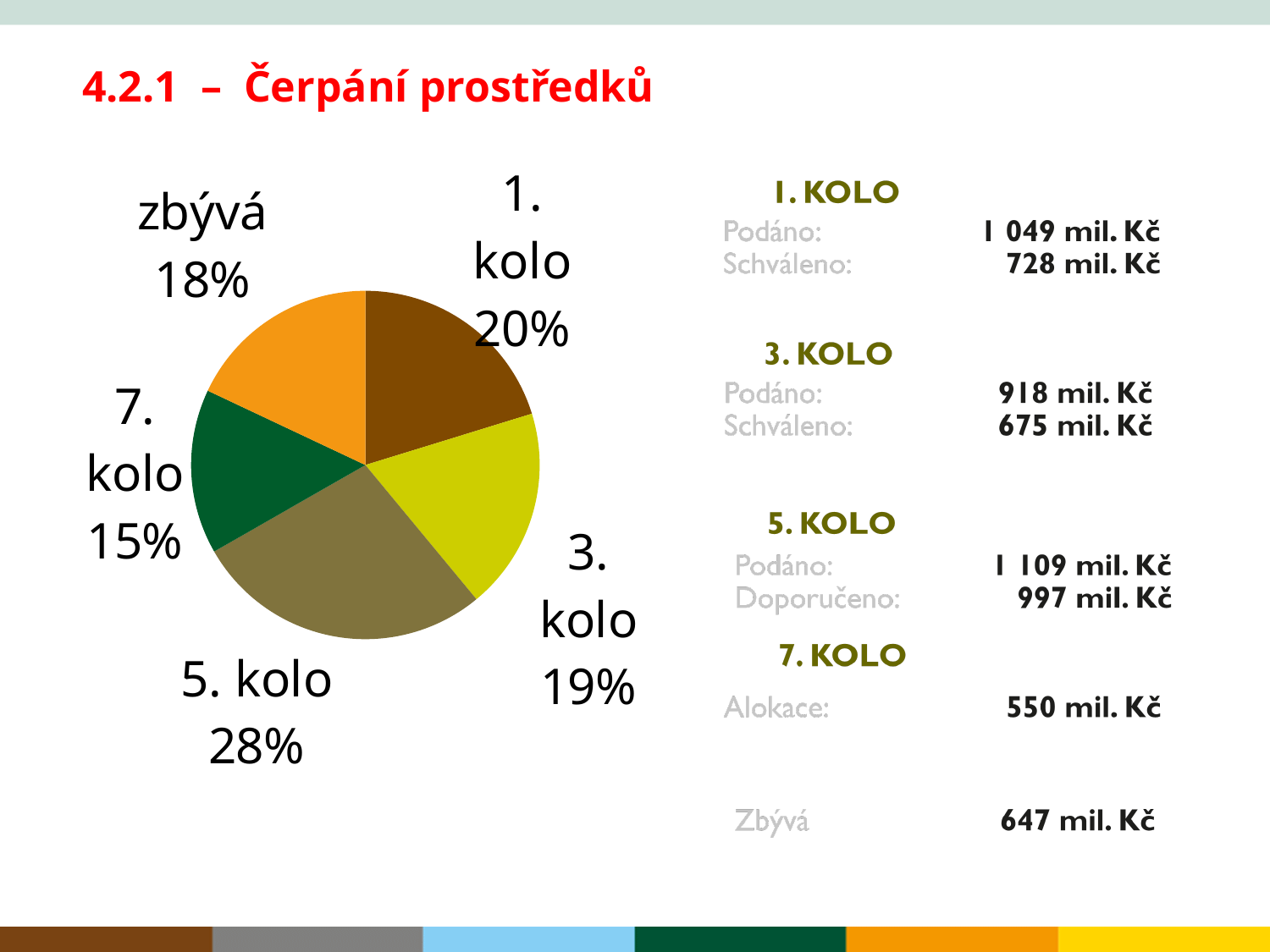
What colour is the "zbývá" slice of the pie chart? orange What kind of chart is shown on the slide? pie chart Which is larger, the share for "1. kolo" or the share for "zbývá"? 1. kolo What is the difference in percentage points between "5. kolo" and "3. kolo"? 9 Which slice of the pie chart is the smallest? 7. kolo Which slice of the pie chart is the largest? 5. kolo How many slices does the pie chart have? 5 What share of the pie does "zbývá" represent? 18% What share of the pie does "1. kolo" represent? 20% What is the difference in percentage points between "zbývá" and "7. kolo"? 3 What share of the pie does "7. kolo" represent? 15%